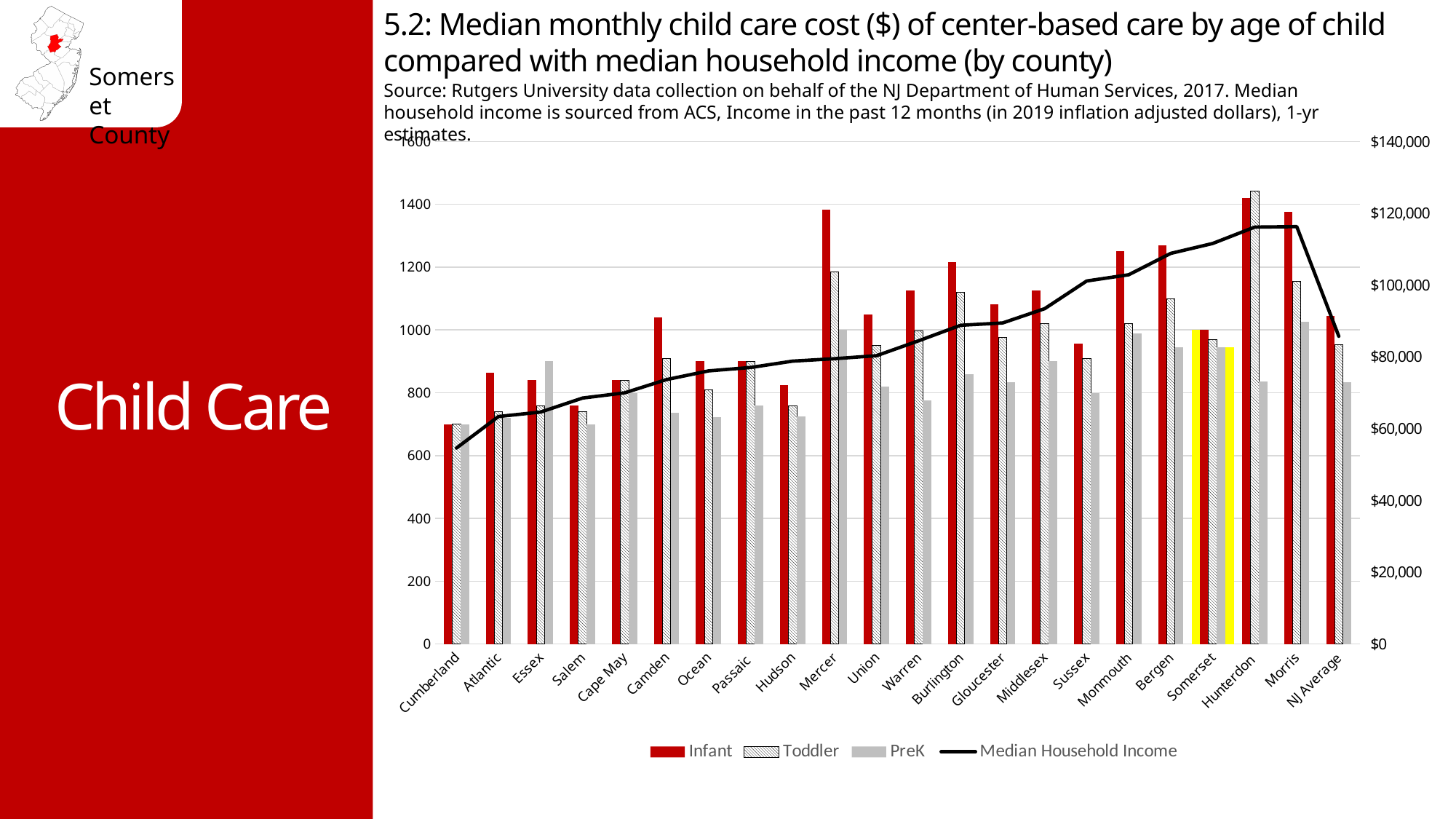
In Essex, which is larger, the Infant bar or the PreK bar? PreK Is the Infant value for Cumberland greater or less than 800? less How many categories are shown along the x axis? 22 Does the Median Household Income line generally rise or fall from Cumberland to Morris? rise What kind of chart is shown on the slide? Bar chart with a line How many series does the legend list? 4 Which county has the highest Toddler bar? Hunterdon Is the Median Household Income for Cumberland greater or less than $60,000? less Which county's bars are highlighted in yellow? Somerset Is the Infant value for Mercer greater or less than 1200? greater Which county has the lowest Infant bar? Cumberland